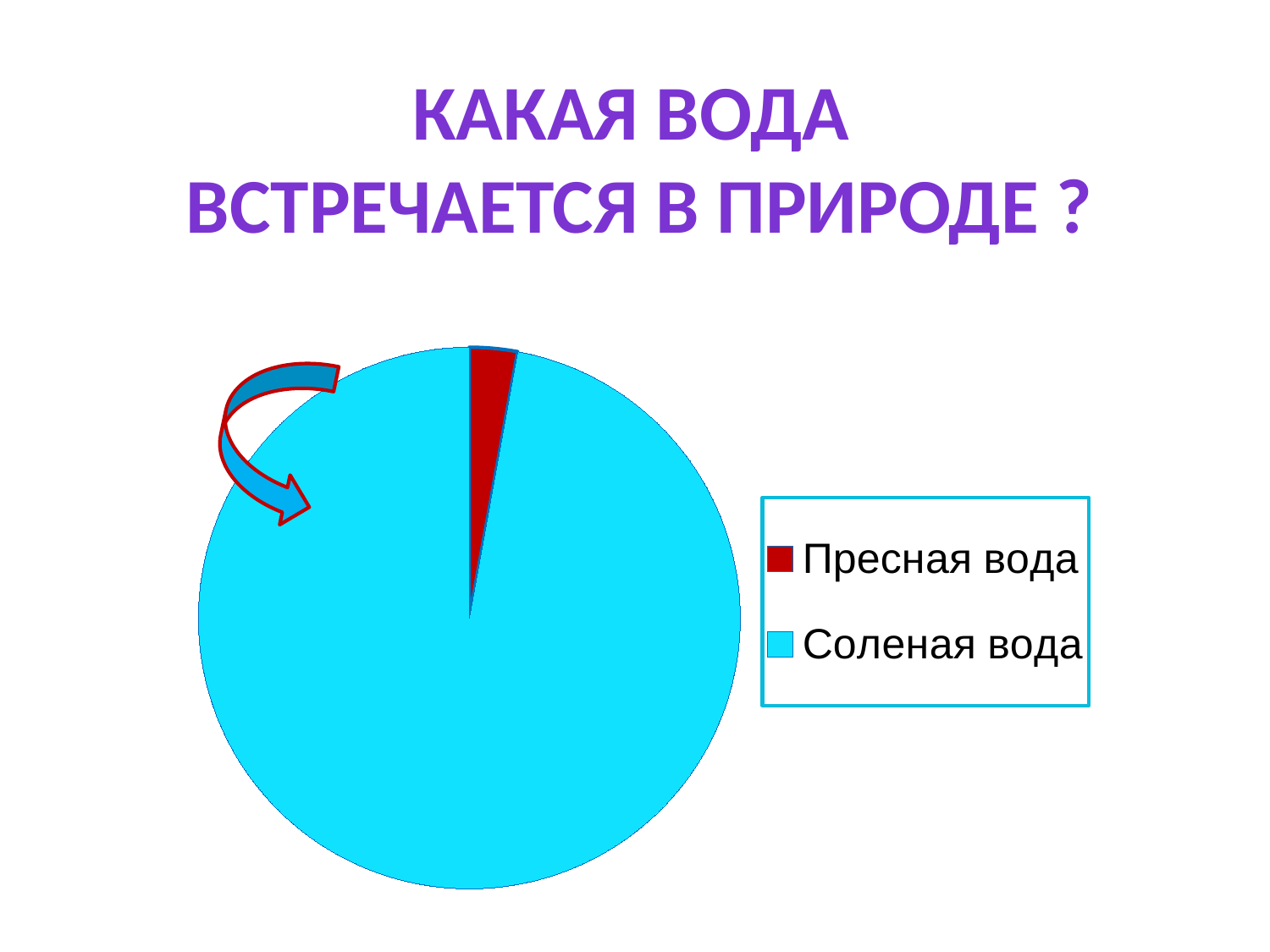
What is the title of the slide containing the pie chart? КАКАЯ ВОДА ВСТРЕЧАЕТСЯ В ПРИРОДЕ ? How many entries does the legend of the pie chart list? 2 How many slices does the pie chart have? 2 What kind of chart is shown on the slide? pie chart Which category has the smallest slice in the pie chart? Пресная вода Which slice is larger in the pie chart, Пресная вода or Соленая вода? Соленая вода What colour is the slice for Пресная вода in the pie chart? red Which category has the largest slice in the pie chart? Соленая вода